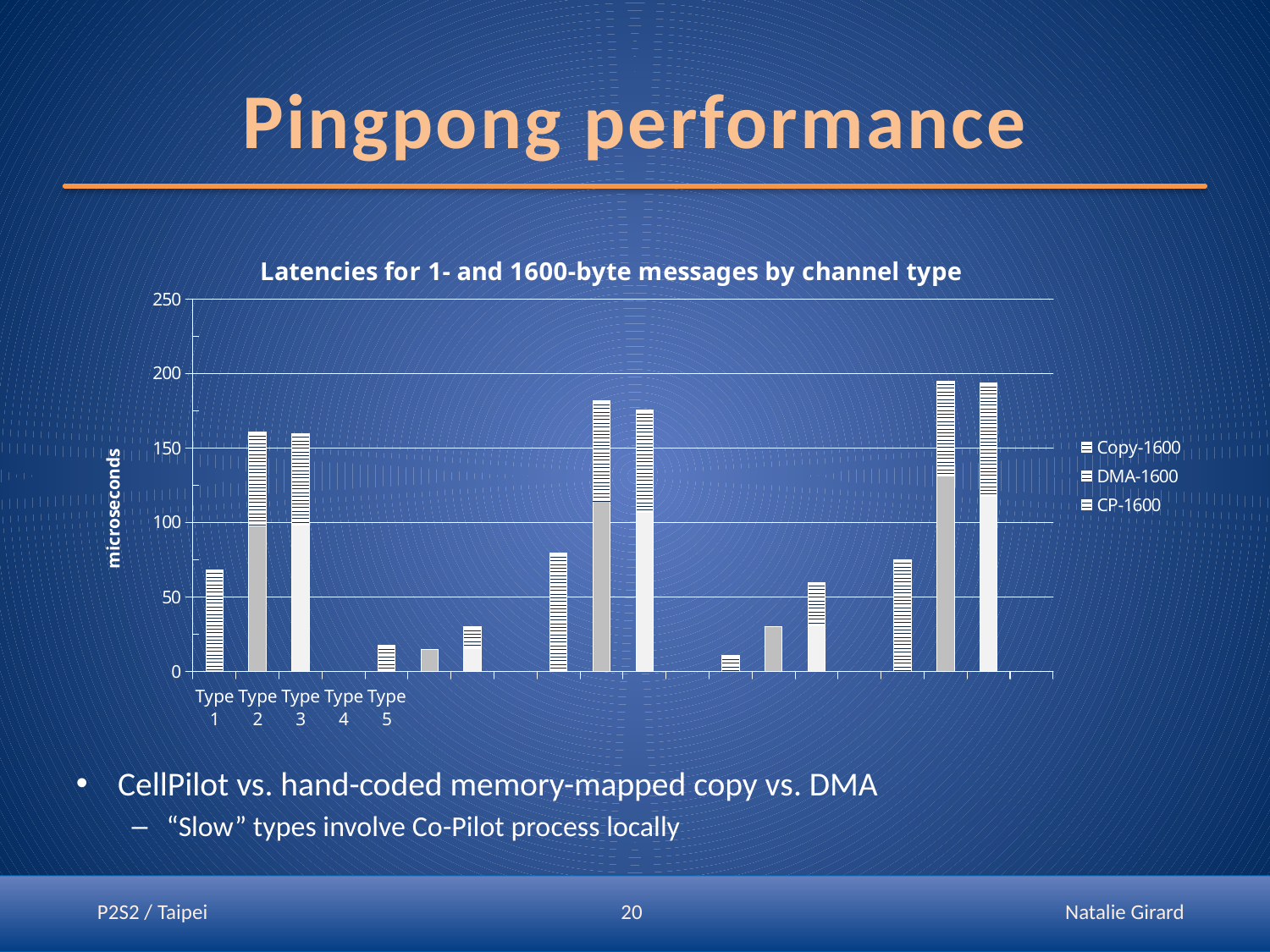
Is the value of the bar for Type 1 greater or less than 100? less What kind of chart is shown on the slide? bar chart Is the value of the tall bar for Type 2 greater or less than 150? greater Is the value of the bar for Type 5 greater or less than 50? less What is the title of the chart? Latencies for 1- and 1600-byte messages by channel type Which is larger, the bar for Type 1 or the bar for Type 5? Type 1 What is the label on the vertical axis of the chart? microseconds What is the highest value shown on the vertical axis of the chart? 250 Which is larger, the tall bar for Type 2 or the bar for Type 1? Type 2 How many series does the chart's legend list? 3